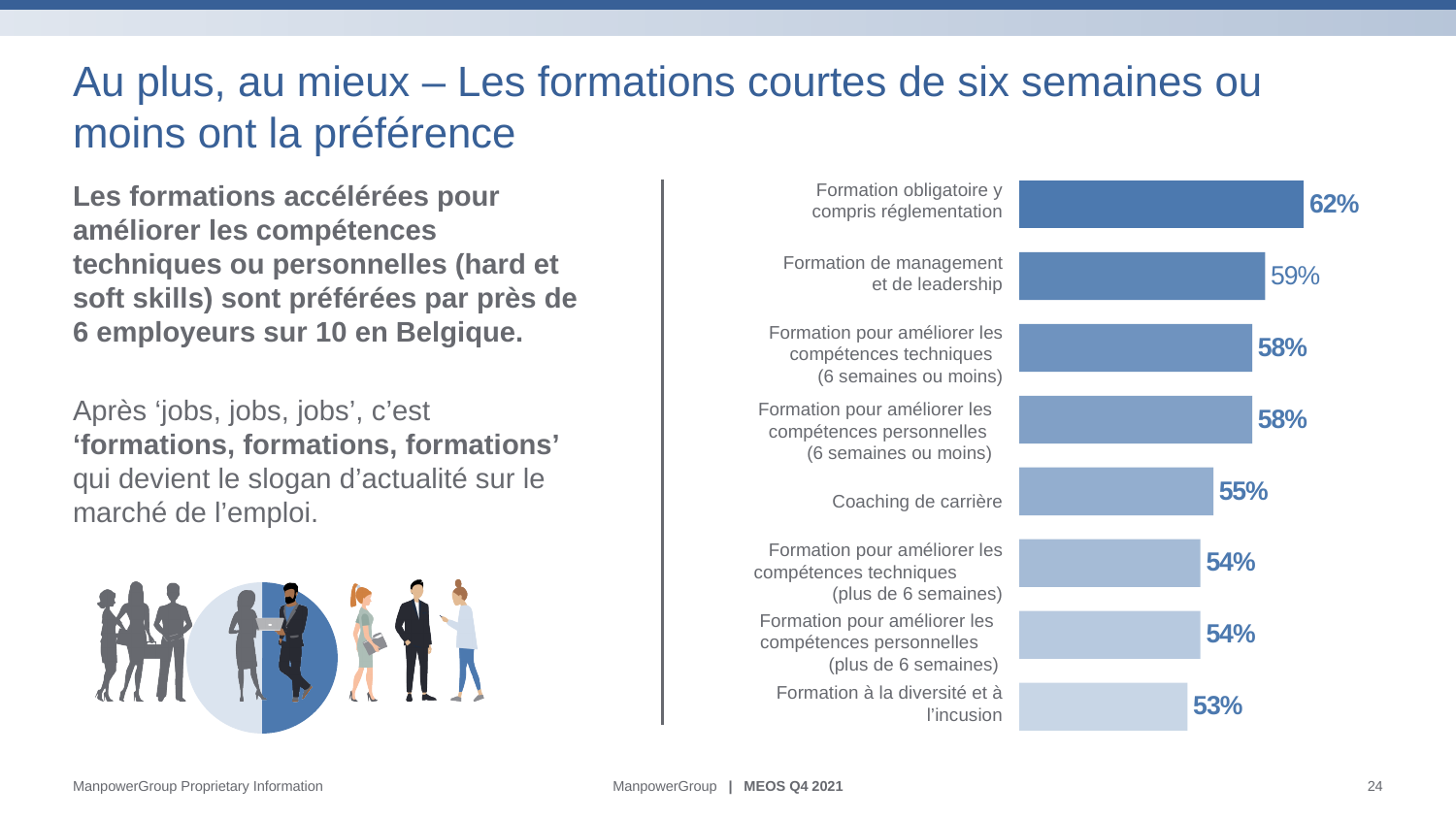
What is the value for 'Formation à la diversité et à l'incusion'? 53% What is the value for 'Formation de management et de leadership'? 59% What is the value for 'Formation pour améliorer les compétences techniques (plus de 6 semaines)'? 54% What is the difference between 'Formation de management et de leadership' and 'Coaching de carrière'? 4% How many categories are shown in the chart? 8 Which category has the lowest value? Formation à la diversité et à l'incusion Which category has the highest value? Formation obligatoire y compris réglementation What kind of chart is shown on the slide? Bar chart What is the value for 'Formation obligatoire y compris réglementation'? 62% What is the value for 'Coaching de carrière'? 55% Which is larger: 'Formation de management et de leadership' or 'Coaching de carrière'? Formation de management et de leadership What is the difference between the values for 'Formation obligatoire y compris réglementation' and 'Formation à la diversité et à l'incusion'? 9%